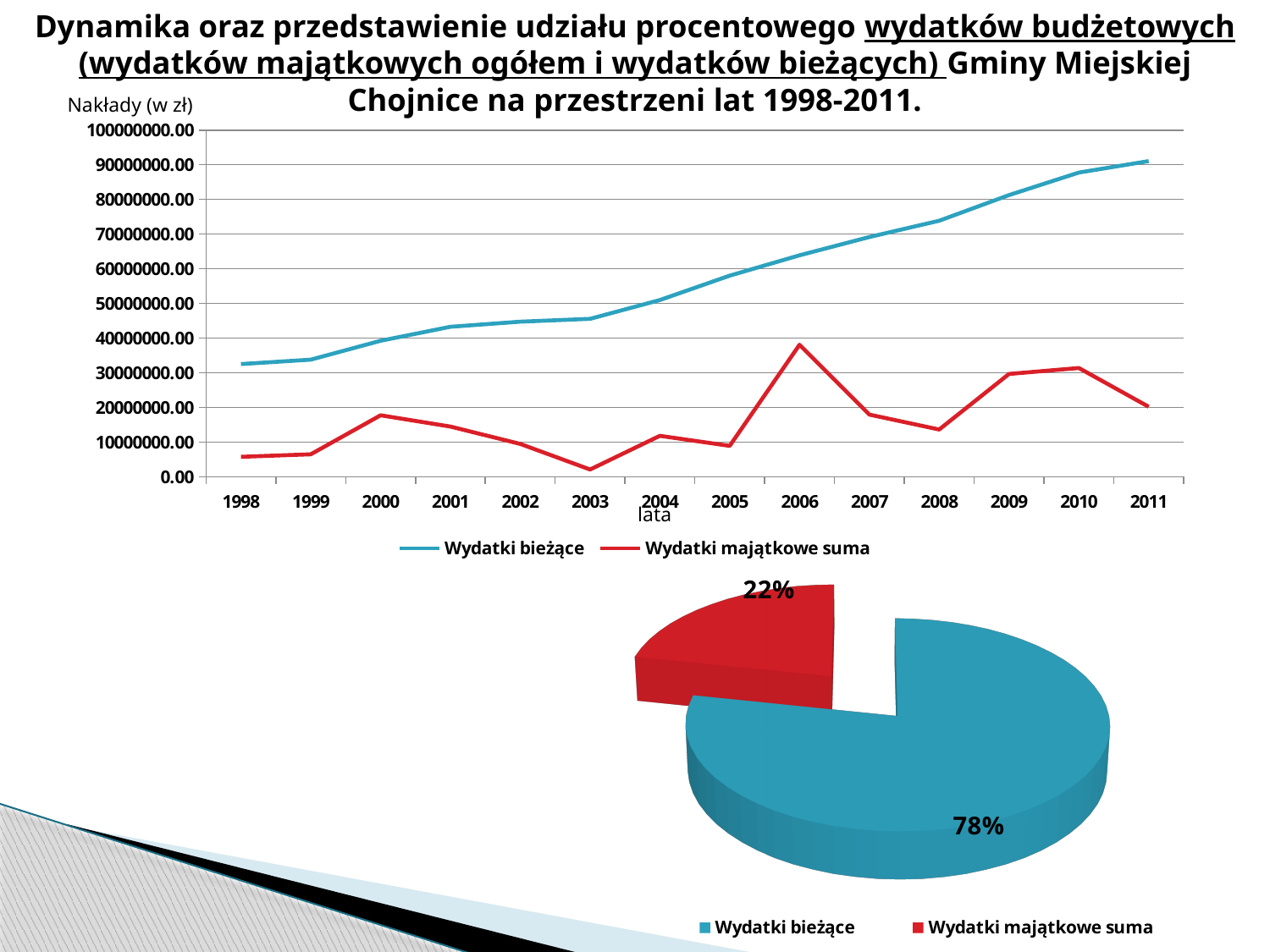
In the top line chart, does Wydatki bieżące generally rise or fall from 1998 to 2011? rise In the top line chart, in which year is Wydatki majątkowe suma lowest? 2003 What kind of chart is the top chart on the slide? line chart In the top line chart, how many years are shown on the x axis? 14 In the top line chart, in which year is Wydatki bieżące highest? 2011 In the top line chart, in which year is Wydatki majątkowe suma highest? 2006 In the top line chart, is the value for Wydatki majątkowe suma in 2006 greater or less than 30000000.00? greater In the bottom pie chart, what share does Wydatki majątkowe suma have? 22% What kind of chart is the bottom chart on the slide? pie chart In the top line chart, is the value for Wydatki bieżące in 2011 greater or less than 80000000.00? greater In the top line chart, how many series does the legend list? 2 In the bottom pie chart, what share does Wydatki bieżące have? 78%